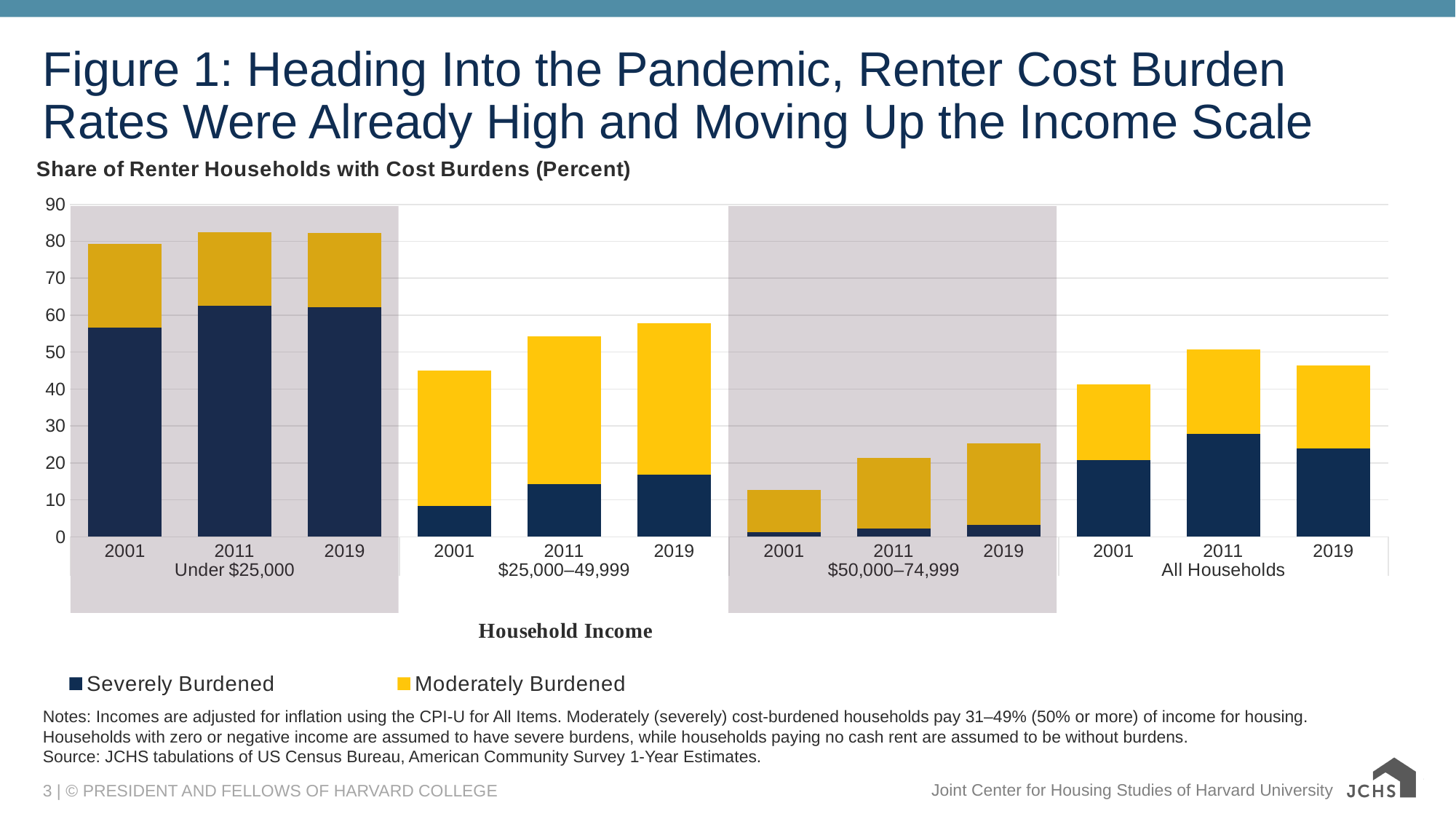
How many series does the legend list? 2 For All Households, is the total cost-burdened share larger in 2011 or 2019? 2011 What kind of chart is shown on the slide? Stacked bar chart Is the total cost-burdened share for 2001 in the $50,000–74,999 group greater or less than 20? less How many household income groups are shown along the x axis? 4 Which colour represents Severely Burdened in the legend? Dark navy blue Is the total cost-burdened share for 2019 in the Under $25,000 group greater or less than 70? greater Is the Severely Burdened share for 2001 in the $25,000–49,999 group greater or less than 10? less How many bars are plotted in total on the chart? 12 Which income group has the lowest total cost-burdened shares? $50,000–74,999 Which income group has the highest total cost-burdened shares? Under $25,000 Do the total cost-burdened shares for the $25,000–49,999 group rise or fall from 2001 to 2019? rise